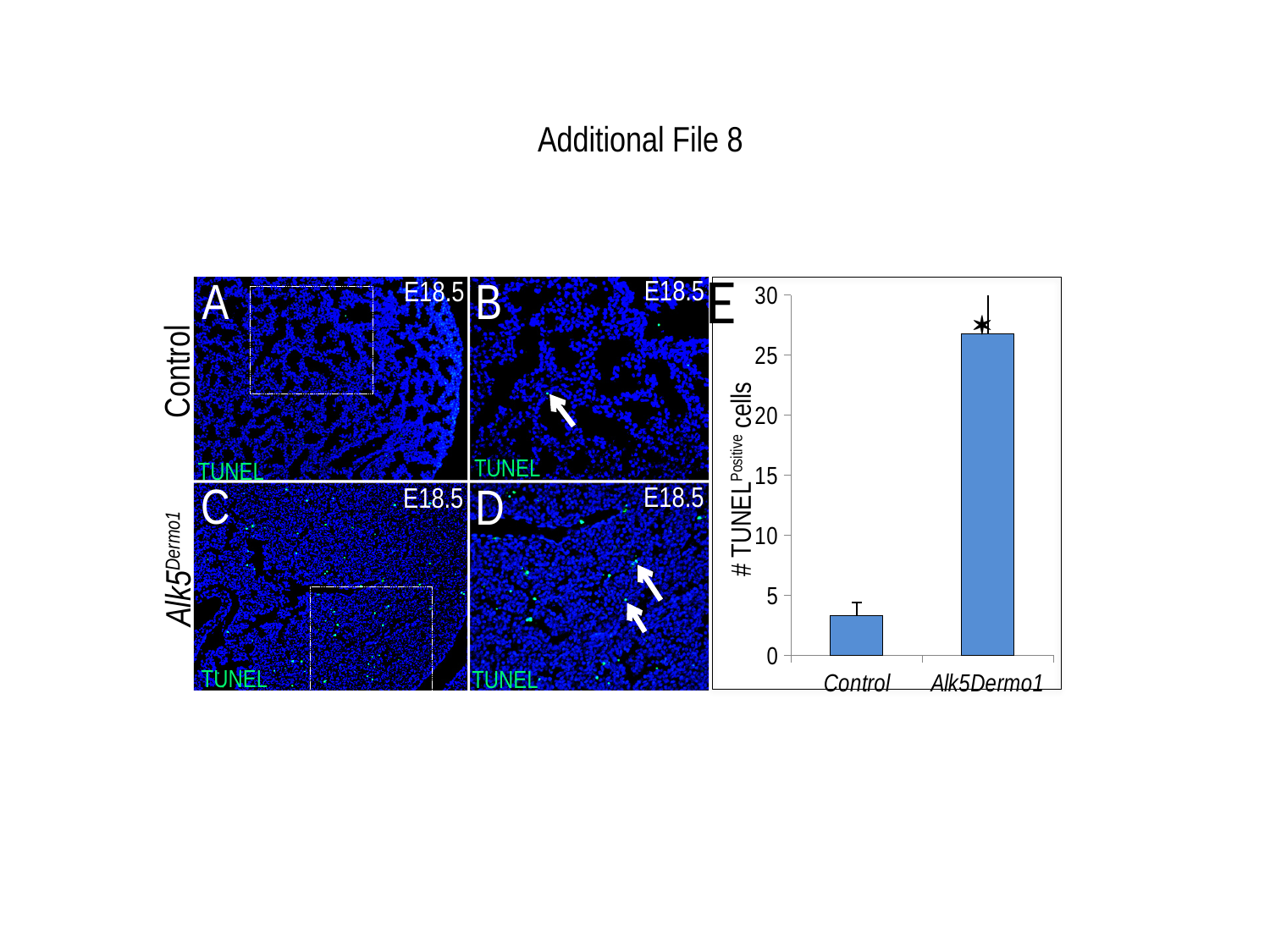
In the bar chart in panel E, which is larger, the value for Control or the value for Alk5Dermo1? Alk5Dermo1 Do the bar values in panel E rise or fall going from Control to Alk5Dermo1? rise How many categories are plotted on the x axis of the bar chart in panel E? 2 Which category has the lowest value in the bar chart in panel E? Control In the bar chart in panel E, is the value for Alk5Dermo1 greater or less than 25? greater In the bar chart in panel E, is the value for Control greater or less than 10? less In the bar chart in panel E, is the value for Alk5Dermo1 greater or less than 30? less What is the label of the y axis of the bar chart in panel E? # TUNEL Positive cells Which category has the highest value in the bar chart in panel E? Alk5Dermo1 What is the highest tick value shown on the y axis of the bar chart in panel E? 30 What kind of chart is shown in panel E? bar chart